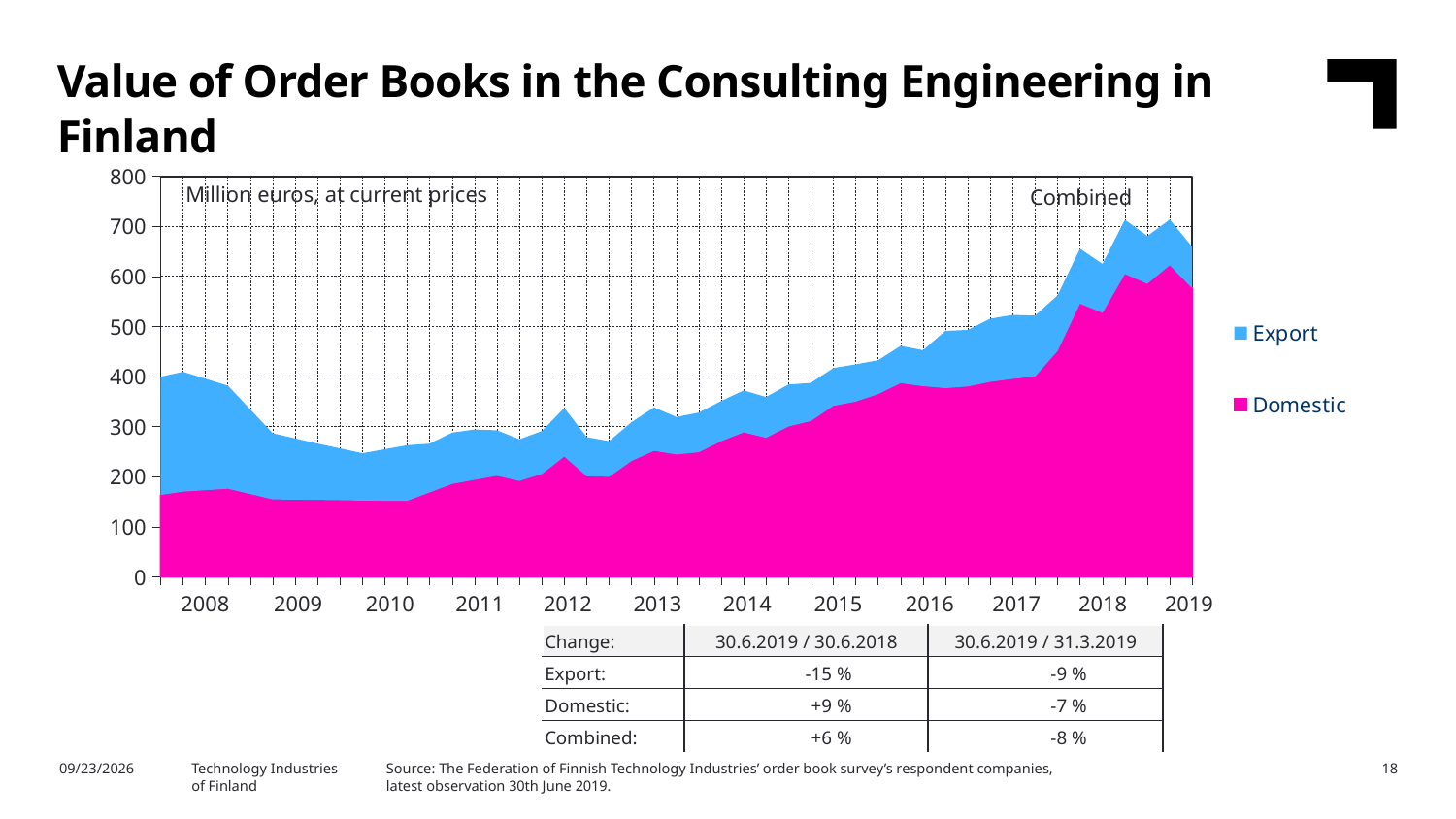
Is the Domestic value at the start of 2008 greater or less than 200? less Which series is larger in 2019, Export or Domestic? Domestic Which two series are listed in the legend? Export and Domestic What kind of chart is shown on the slide? Stacked area chart How many years are labelled on the x axis? 12 Does the combined value rise or fall from 2010 to 2018? rise Is the combined value around 2016 greater or less than 400? greater Does the Domestic value rise or fall from 2012 to 2019? rise In what unit are the values on the chart expressed, according to the label inside the plot area? Million euros, at current prices Is the combined value at the end of the series in 2019 greater or less than 600? greater How many series does the legend list? 2